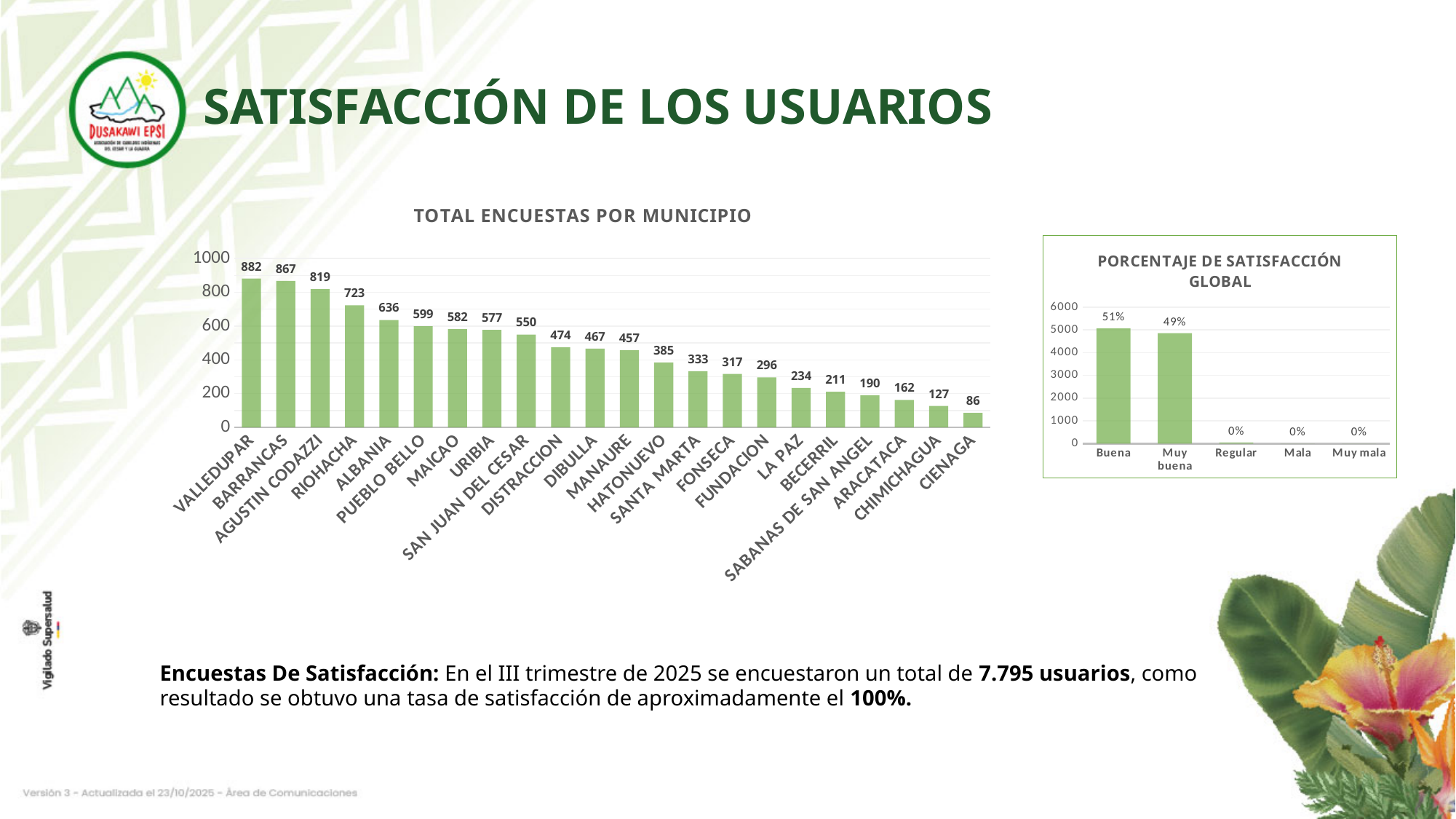
In the 'PORCENTAJE DE SATISFACCIÓN GLOBAL' chart, is the value for 'Buena' greater or less than 4000? greater In the 'TOTAL ENCUESTAS POR MUNICIPIO' chart, how many municipalities are shown? 22 What kind of chart is 'TOTAL ENCUESTAS POR MUNICIPIO'? bar chart In the 'TOTAL ENCUESTAS POR MUNICIPIO' chart, what is the difference between the values for VALLEDUPAR and BARRANCAS? 15 In the 'TOTAL ENCUESTAS POR MUNICIPIO' chart, which is larger, the value for MAICAO or the value for DIBULLA? MAICAO In the 'PORCENTAJE DE SATISFACCIÓN GLOBAL' chart, what is the percentage label for 'Muy buena'? 49% In the 'PORCENTAJE DE SATISFACCIÓN GLOBAL' chart, how many categories are shown on the x axis? 5 In the 'TOTAL ENCUESTAS POR MUNICIPIO' chart, which municipality has the lowest value? CIENAGA In the 'TOTAL ENCUESTAS POR MUNICIPIO' chart, what is the value for RIOHACHA? 723 In the 'TOTAL ENCUESTAS POR MUNICIPIO' chart, which municipality has the highest value? VALLEDUPAR In the 'TOTAL ENCUESTAS POR MUNICIPIO' chart, what is the value for SANTA MARTA? 333 In the 'TOTAL ENCUESTAS POR MUNICIPIO' chart, do the values rise or fall from left to right? fall